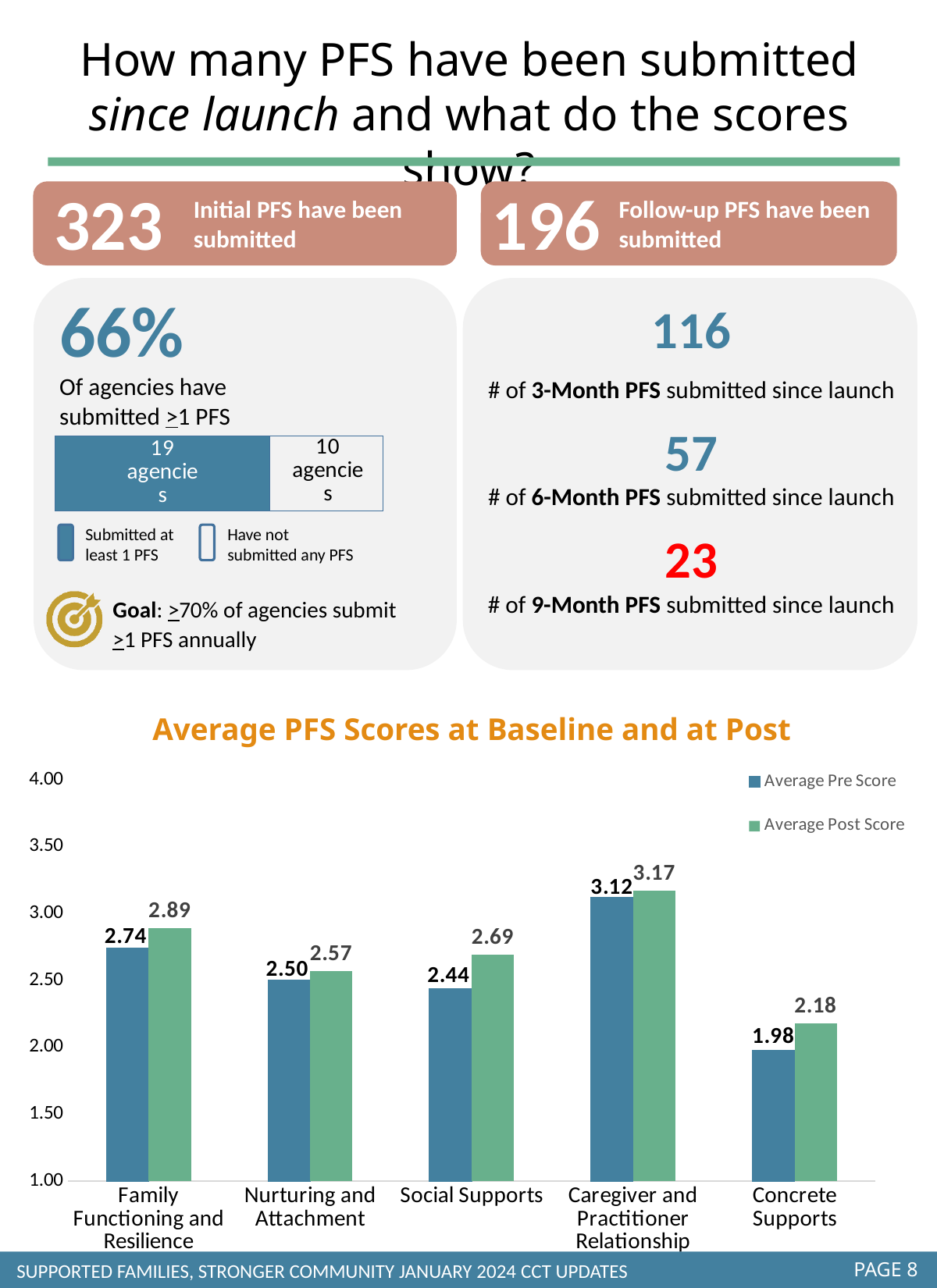
In the small stacked bar in the '66%' box, what is the total number of agencies shown across both segments? 29 In the chart 'Average PFS Scores at Baseline and at Post', which category has the highest Average Post Score? Caregiver and Practitioner Relationship How many categories are shown on the x axis of the chart 'Average PFS Scores at Baseline and at Post'? 5 In the chart 'Average PFS Scores at Baseline and at Post', is the Average Pre Score for Caregiver and Practitioner Relationship greater or less than 3.00? greater What kind of chart is 'Average PFS Scores at Baseline and at Post'? bar chart In the chart 'Average PFS Scores at Baseline and at Post', what is the Average Pre Score for Social Supports? 2.44 How many series does the legend of the chart 'Average PFS Scores at Baseline and at Post' list? 2 In the chart 'Average PFS Scores at Baseline and at Post', what is the Average Post Score for Concrete Supports? 2.18 In the chart 'Average PFS Scores at Baseline and at Post', which category has the lowest Average Pre Score? Concrete Supports In the chart 'Average PFS Scores at Baseline and at Post', which is larger: the Average Pre Score for Nurturing and Attachment or the Average Pre Score for Social Supports? Nurturing and Attachment In the chart 'Average PFS Scores at Baseline and at Post', by how much does the Average Post Score exceed the Average Pre Score for Social Supports? 0.25 In the chart 'Average PFS Scores at Baseline and at Post', what is the difference between the Average Post Score and the Average Pre Score for Family Functioning and Resilience? 0.15